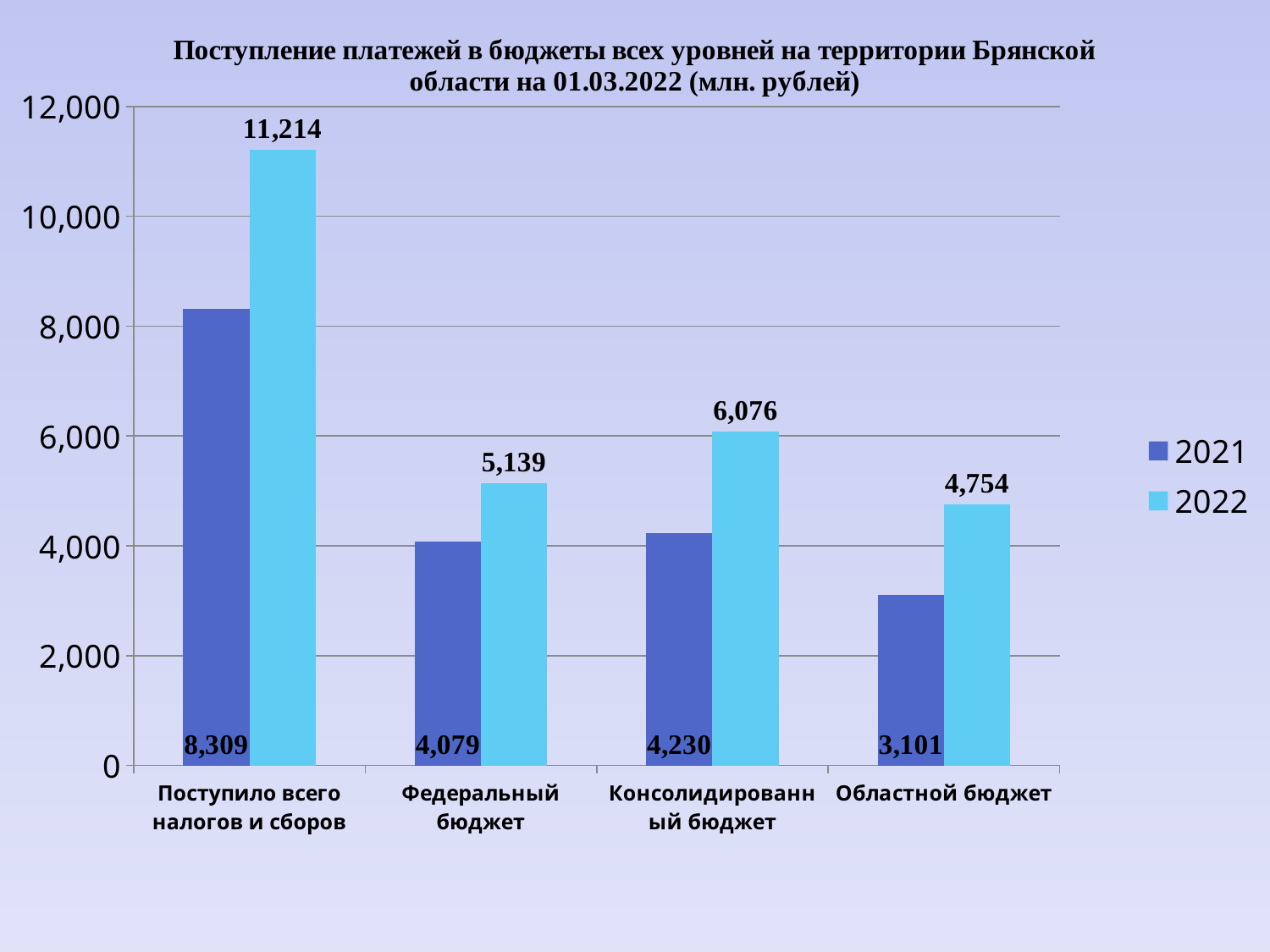
Which category has the highest 2022 value? Поступило всего налогов и сборов What is the difference between the 2022 and 2021 values for Поступило всего налогов и сборов? 2,905 How many categories are shown on the x axis? 4 What is the 2021 value for Федеральный бюджет? 4,079 What is the 2021 value for Областной бюджет? 3,101 Is the 2021 value for Консолидированный бюджет greater or less than 4,000? greater How many series does the legend list? 2 Which is larger for Областной бюджет: the 2021 value or the 2022 value? 2022 What is the 2022 value for Поступило всего налогов и сборов? 11,214 What is the 2022 value for Консолидированный бюджет? 6,076 Which category has the lowest 2021 value? Областной бюджет What kind of chart is shown on the slide? bar chart